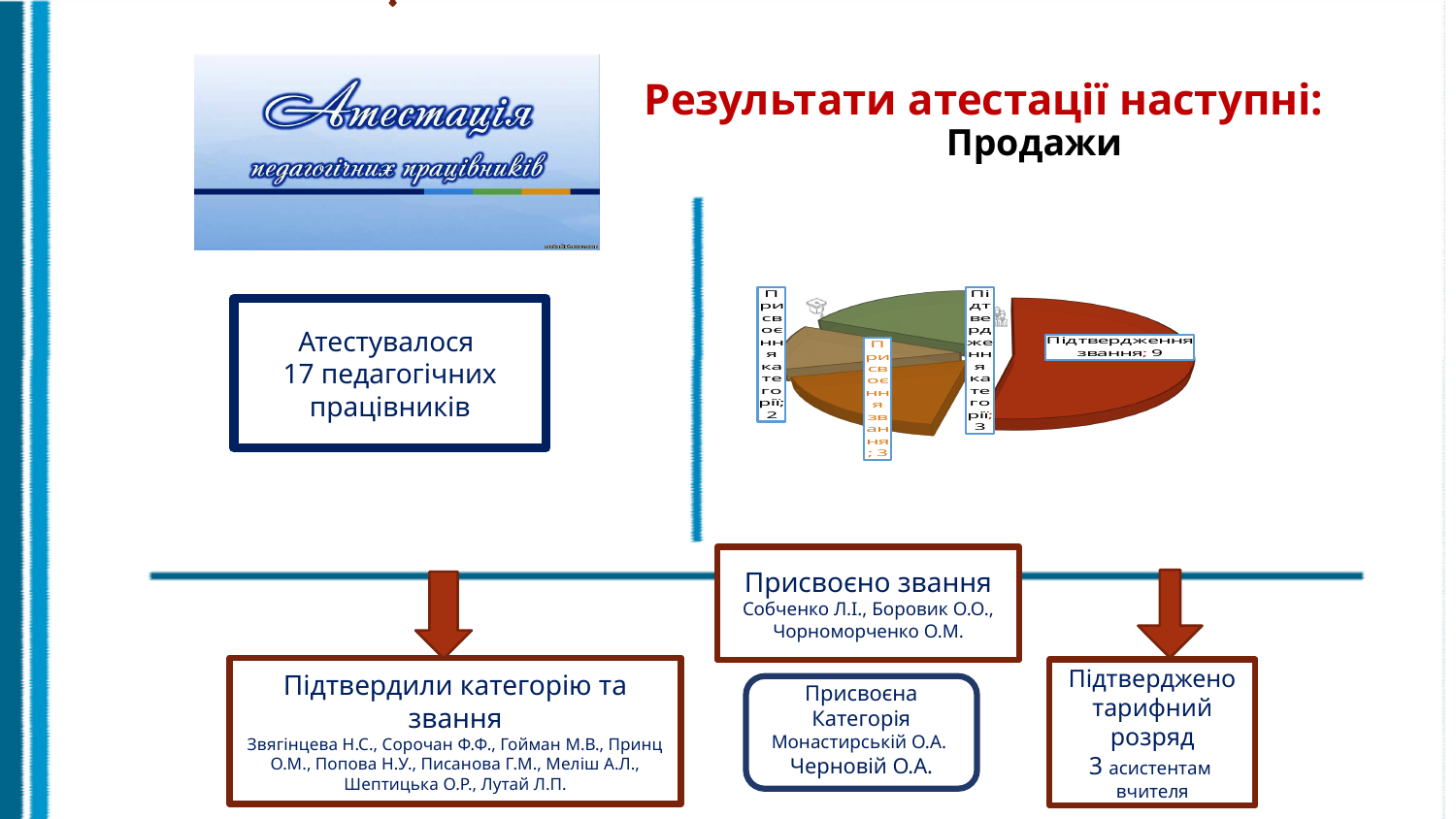
What is the value for Присвоєння категорії? 2 Which category has the largest slice of the pie? Підтвердження звання What is the value for Підтвердження категорії? 3 Which is larger, the value for Присвоєння звання or the value for Присвоєння категорії? Присвоєння звання What kind of chart is shown on the slide? pie chart What is the value for Підтвердження звання? 9 How many slices does the pie chart have? 4 What is the title of the chart? Продажи What is the difference between the values for Підтвердження звання and Присвоєння категорії? 7 Which category has the smallest slice of the pie? Присвоєння категорії What is the total of all the slice values in the pie chart? 17 What is the value for Присвоєння звання? 3